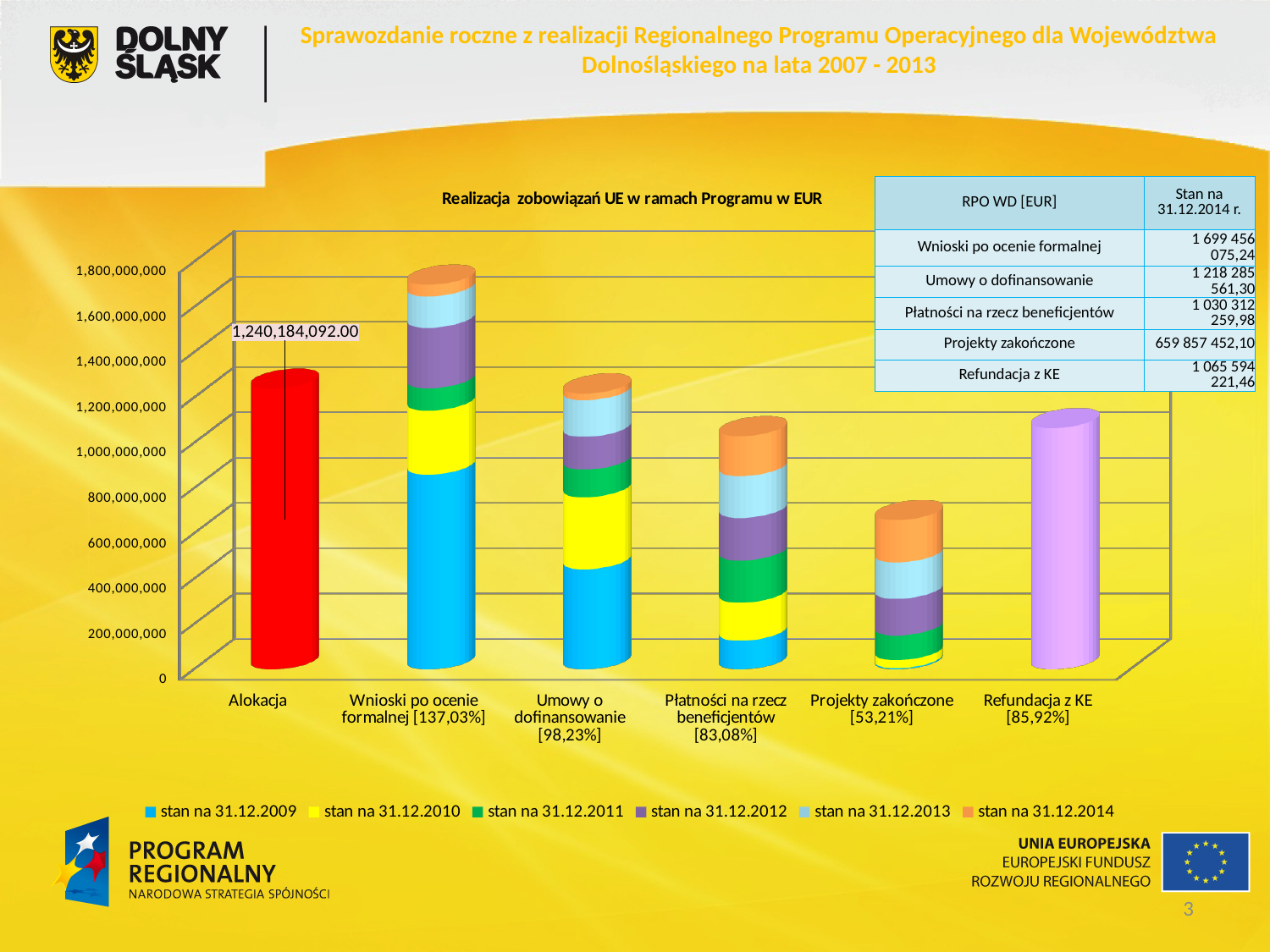
What kind of chart is shown on the slide? stacked bar chart Is the total value for Umowy o dofinansowanie greater or less than 1,000,000,000? greater Which category has the shortest bar in the chart? Projekty zakończone [53,21%] Which bar is taller: Wnioski po ocenie formalnej or Umowy o dofinansowanie? Wnioski po ocenie formalnej What is the title of the chart? Realizacja zobowiązań UE w ramach Programu w EUR How many categories are shown on the x axis of the chart? 6 Is the total value for Projekty zakończone greater or less than 800,000,000? less How many series does the chart legend list? 6 Which category has the tallest bar in the chart? Wnioski po ocenie formalnej [137,03%] Is the total value for Wnioski po ocenie formalnej greater or less than 1,600,000,000? greater Which legend entry is shown in red/orange as the last series in the legend? stan na 31.12.2014 What value is labelled on the Alokacja bar? 1,240,184,092.00